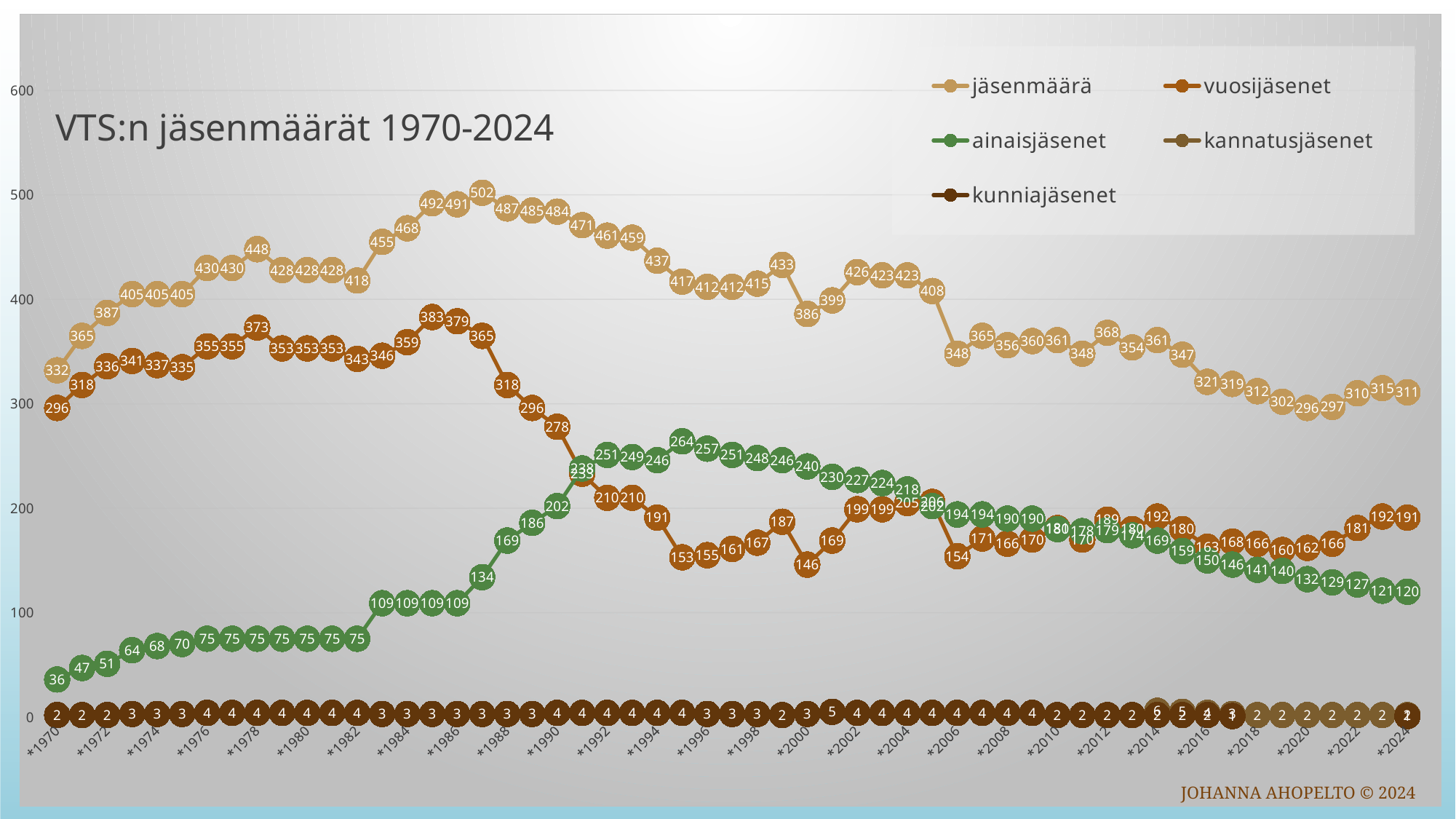
What is the title of the chart? VTS:n jäsenmäärät 1970-2024 What kind of chart is shown on the slide? line chart In 2000, which is larger: ainaisjäsenet or vuosijäsenet? ainaisjäsenet What is the vuosijäsenet value for 1978? 373 What is the vuosijäsenet value for 2000? 146 What is the ainaisjäsenet value for 2024? 120 Does the ainaisjäsenet series rise or fall from 2000 to 2024? fall What is the difference between the jäsenmäärä value for 1970 (332) and for 2024 (311)? 21 What is the jäsenmäärä value for 1970? 332 How many series does the legend list? 5 What is the highest jäsenmäärä value shown on the chart? 502 What is the lowest jäsenmäärä value shown on the chart? 296